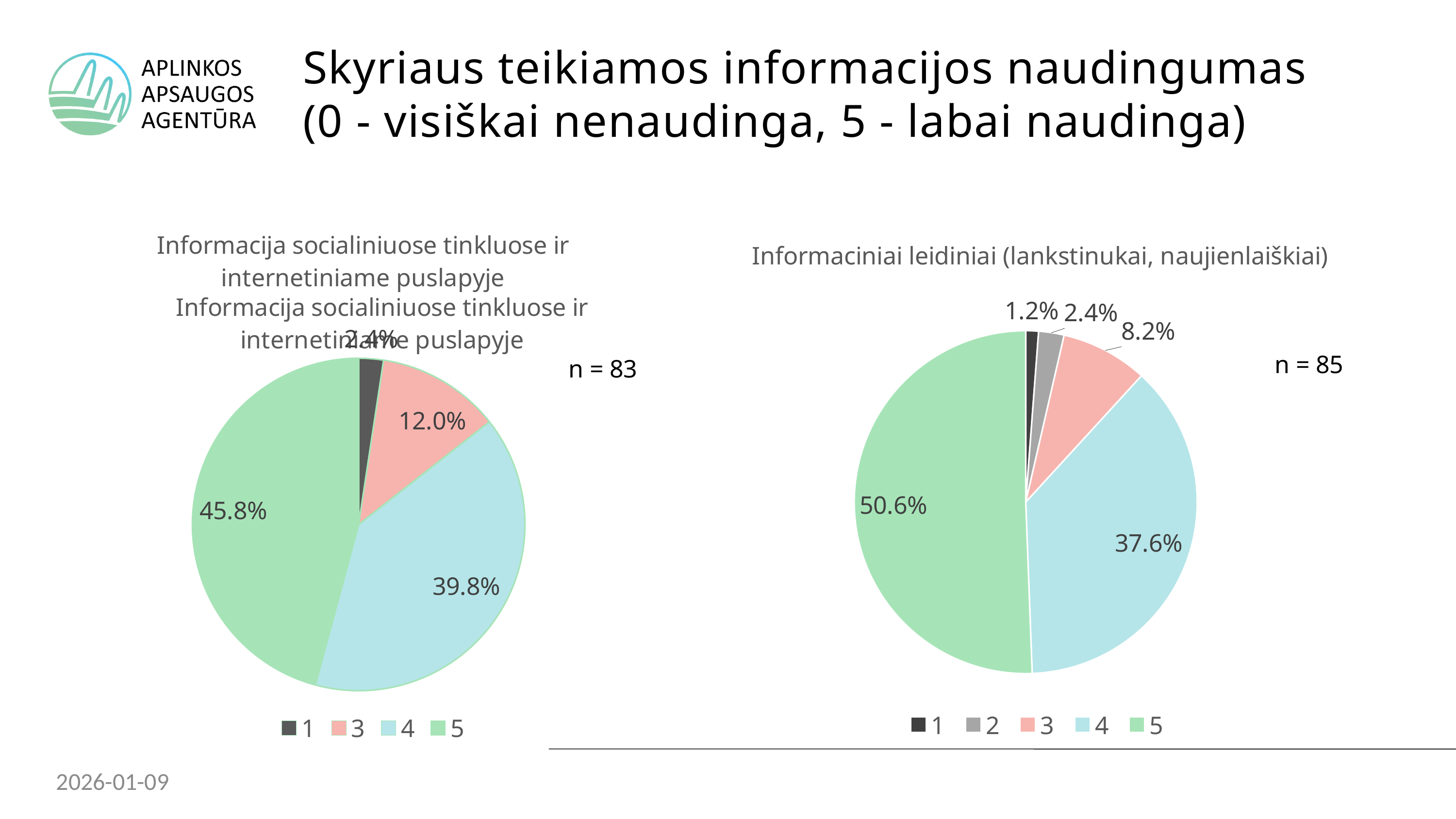
In the left pie chart (Informacija socialiniuose tinkluose ir internetiniame puslapyje), which is larger: the share for rating 4 or rating 3? rating 4 What type of chart is used on this slide? pie chart In the right pie chart (Informaciniai leidiniai), which rating has the largest slice? 5 In the right pie chart (Informaciniai leidiniai), what share is shown for rating 3? 8.2% What is the sample size (n) shown next to the right pie chart (Informaciniai leidiniai)? n = 85 How many legend entries does the right pie chart (Informaciniai leidiniai) list? 5 In the right pie chart (Informaciniai leidiniai), which rating has the smallest slice? 1 In the right pie chart (Informaciniai leidiniai), what is the difference between the shares for rating 5 and rating 4? 13.0% In the right pie chart (Informaciniai leidiniai), what share is shown for rating 5? 50.6% In the left pie chart (Informacija socialiniuose tinkluose ir internetiniame puslapyje), what share is shown for rating 3? 12.0% In the left pie chart (Informacija socialiniuose tinkluose ir internetiniame puslapyje), what share is shown for rating 5? 45.8% In the left pie chart (Informacija socialiniuose tinkluose ir internetiniame puslapyje), what share is shown for rating 4? 39.8%